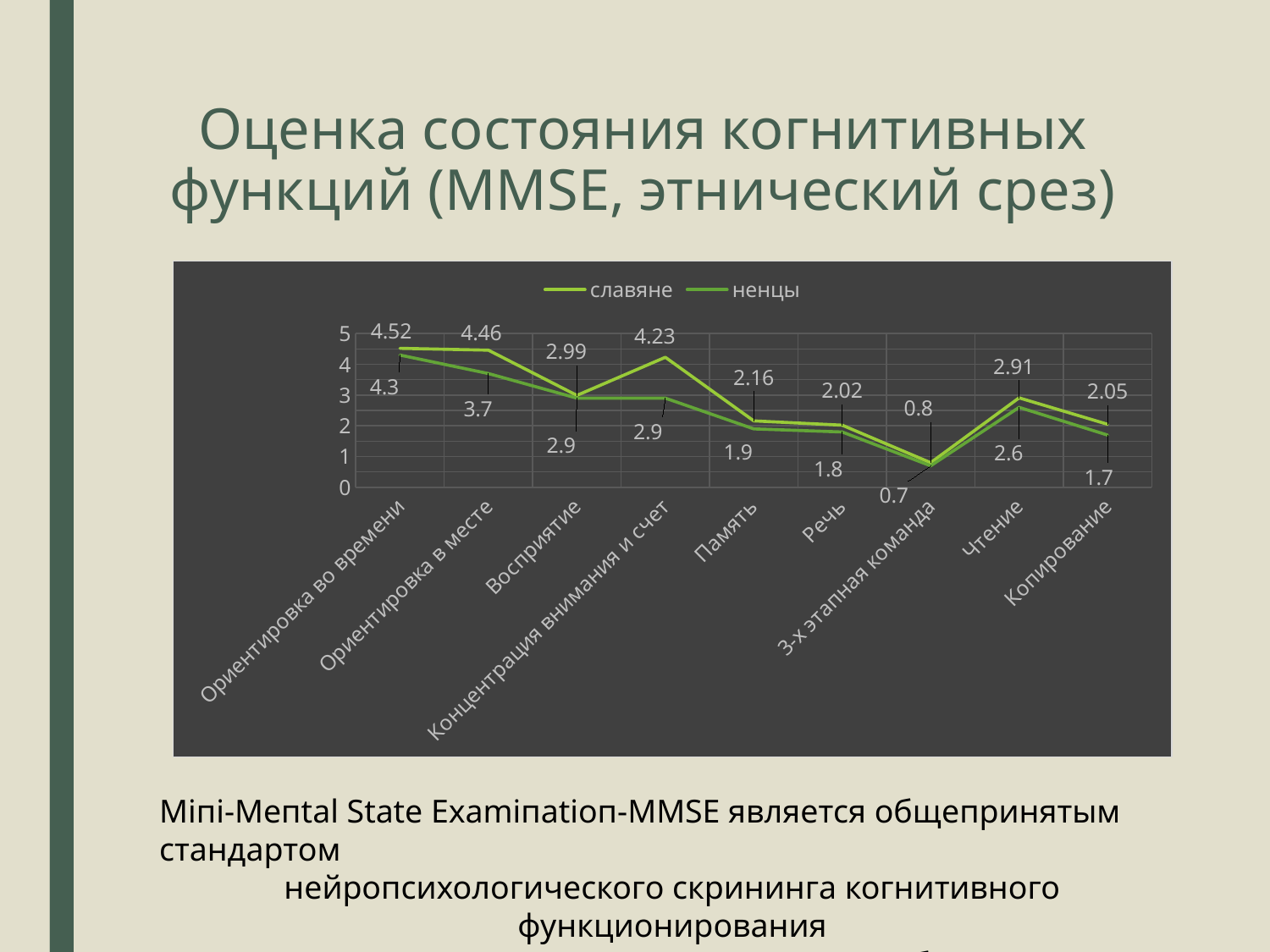
Is the value for ненцы in the category Память greater or less than 2? less What are the two series named in the legend? славяне and ненцы What type of chart is shown on the slide? line chart What is the difference between славяне and ненцы in the category Концентрация внимания и счет? 1.33 Which category has the highest value for славяне? Ориентировка во времени How many series does the legend list? 2 Which category has the lowest value for ненцы? 3-х этапная команда How many categories are shown on the x axis? 9 What is the value for славяне in the category Концентрация внимания и счет? 4.23 What is the value for славяне in the category Ориентировка во времени? 4.52 What is the value for ненцы in the category Ориентировка в месте? 3.7 Which series has the larger value in the category Чтение, славяне or ненцы? славяне